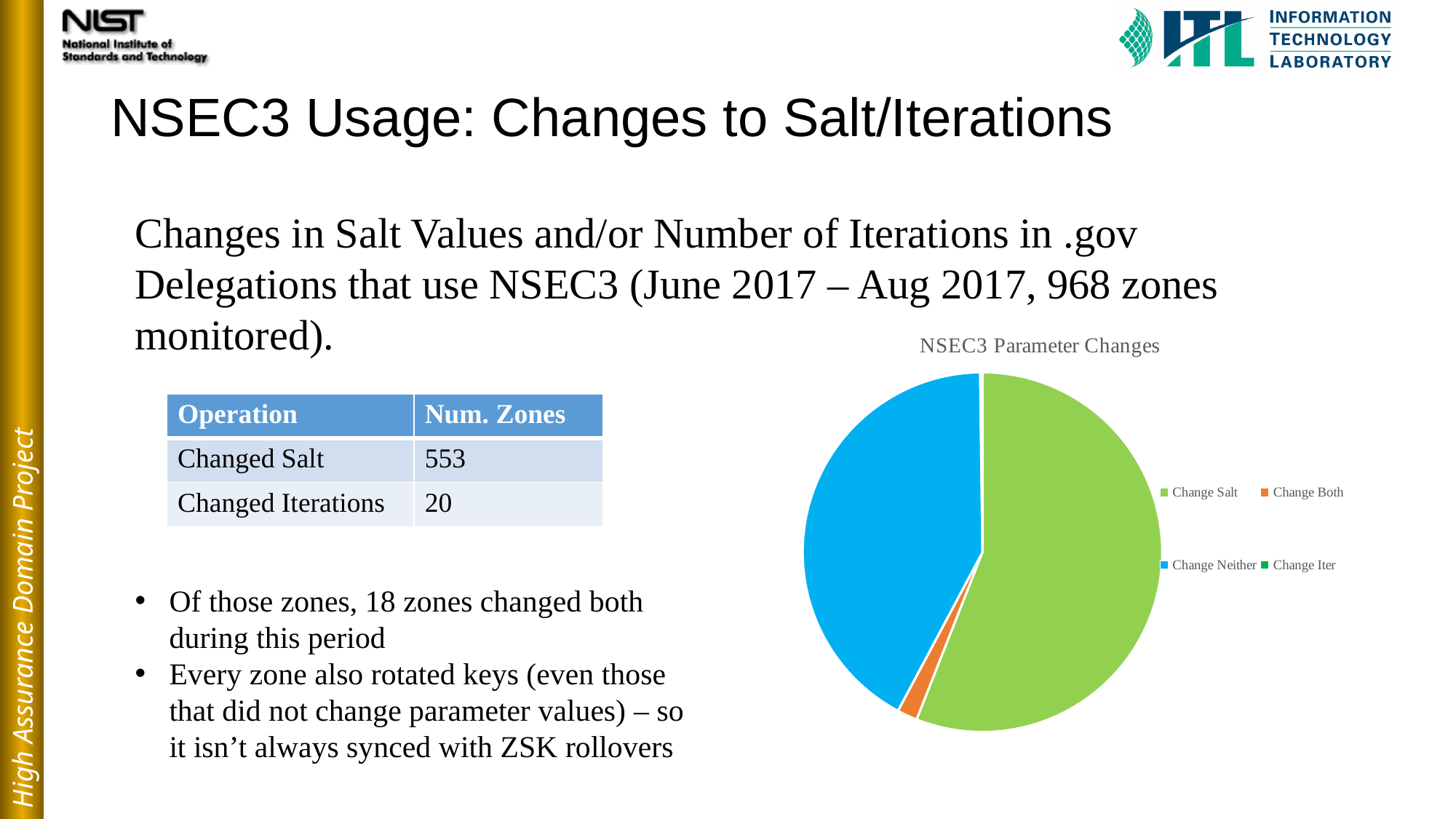
In the pie chart, which slice is larger: Change Both or Change Salt? Change Salt What colour is the Change Neither slice in the pie chart? blue How many categories does the legend of the pie chart list? 4 In the pie chart, which slice is larger: Change Both or Change Neither? Change Neither What kind of chart is shown on the slide? pie chart Which legend entry in the pie chart is shown in orange? Change Both In the pie chart, which slice is larger: Change Salt or Change Neither? Change Salt What is the title of the chart on the slide? NSEC3 Parameter Changes Which category has the largest slice in the NSEC3 Parameter Changes pie chart? Change Salt